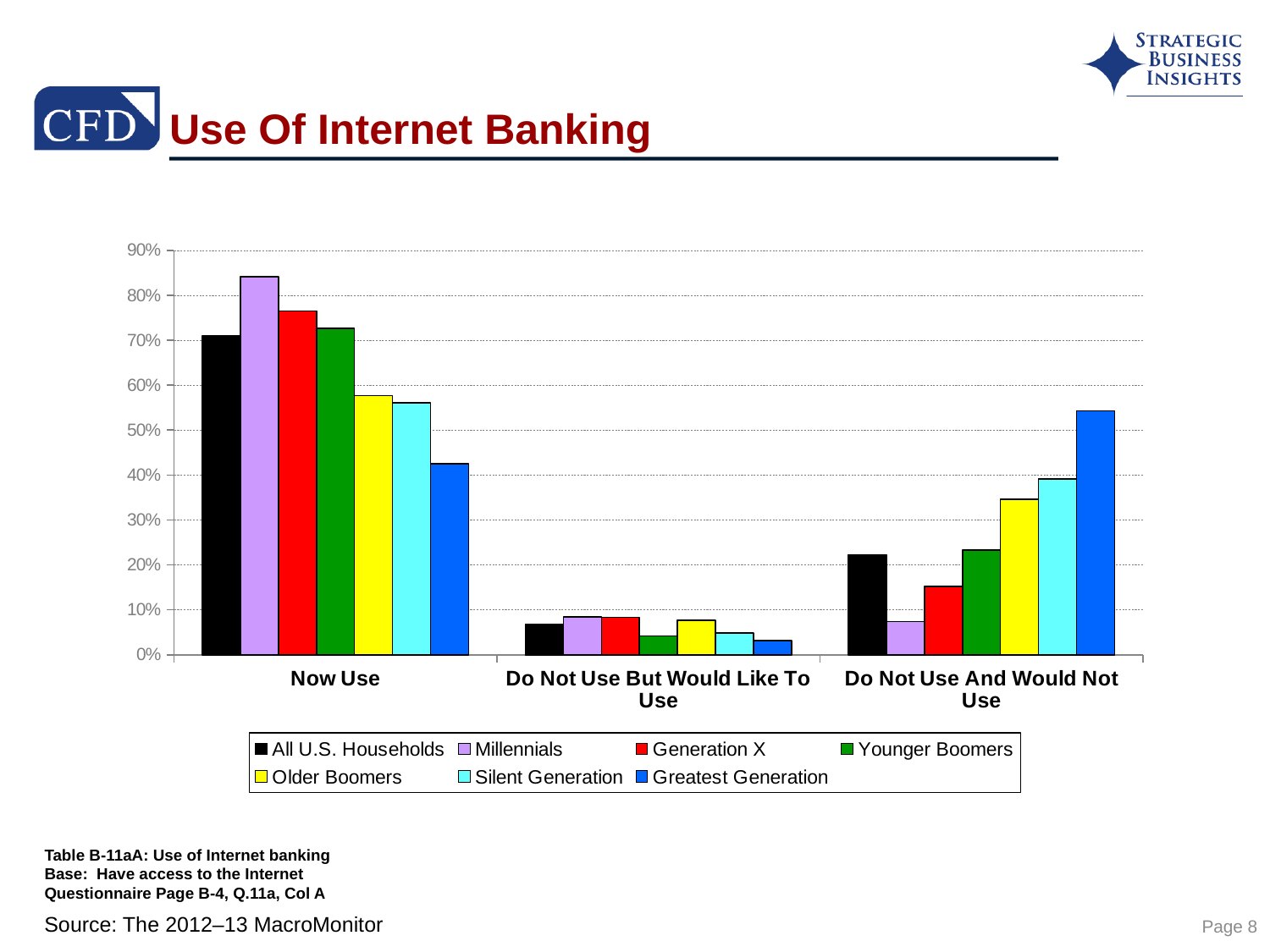
Is the value for Greatest Generation in the "Do Not Use And Would Not Use" category greater or less than 50%? greater What kind of chart is shown on the slide? Bar chart How many categories are shown on the x axis? 3 Is the value for Greatest Generation in the "Now Use" category greater or less than 50%? less In the "Now Use" category, which series has the lowest value? Greatest Generation In the "Do Not Use And Would Not Use" category, which is larger: Older Boomers or Silent Generation? Silent Generation In the "Do Not Use And Would Not Use" category, which series has the highest value? Greatest Generation What is the title of the slide's chart? Use Of Internet Banking In the "Do Not Use And Would Not Use" category, which series has the lowest value? Millennials Is the value for Millennials in the "Now Use" category greater or less than 80%? greater In the "Now Use" category, which series has the highest value? Millennials How many series does the legend list? 7